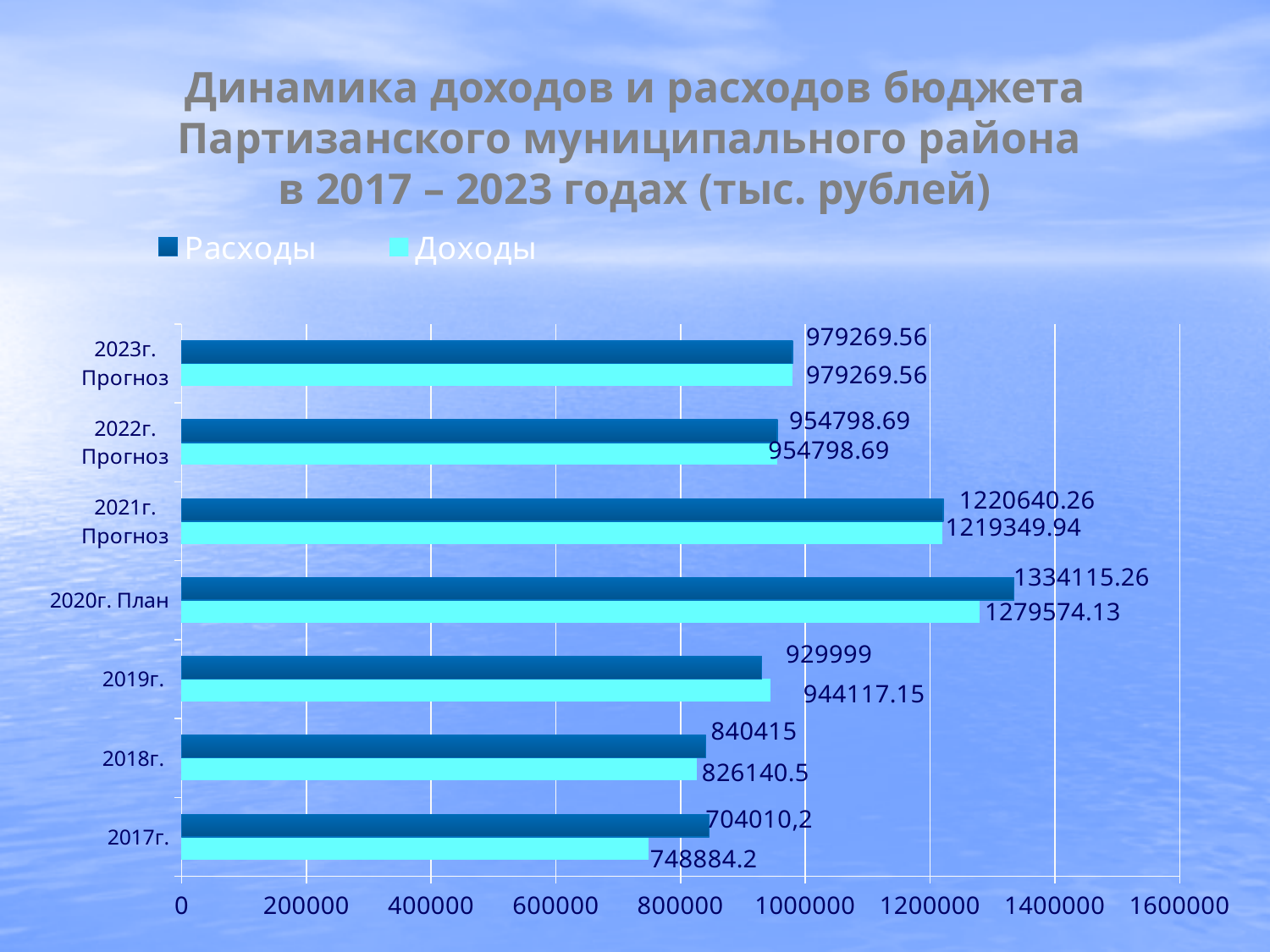
Which category has the highest value of Расходы? 2020г. План Which category has the lowest value of Доходы? 2017г. What is the difference between Расходы and Доходы for 2020г. План? 54541.13 What is the value of Доходы for 2021г. Прогноз? 1219349.94 What type of chart is shown on the slide? bar chart Is the value of Доходы for 2018г. greater or less than 1000000? less How many year categories are shown on the chart? 7 Which series is shown in dark blue in the legend? Расходы How many series does the legend list? 2 For 2019г., which is larger: Расходы or Доходы? Доходы What is the value of Расходы for 2020г. План? 1334115.26 What is the value of Доходы for 2017г.? 748884.2